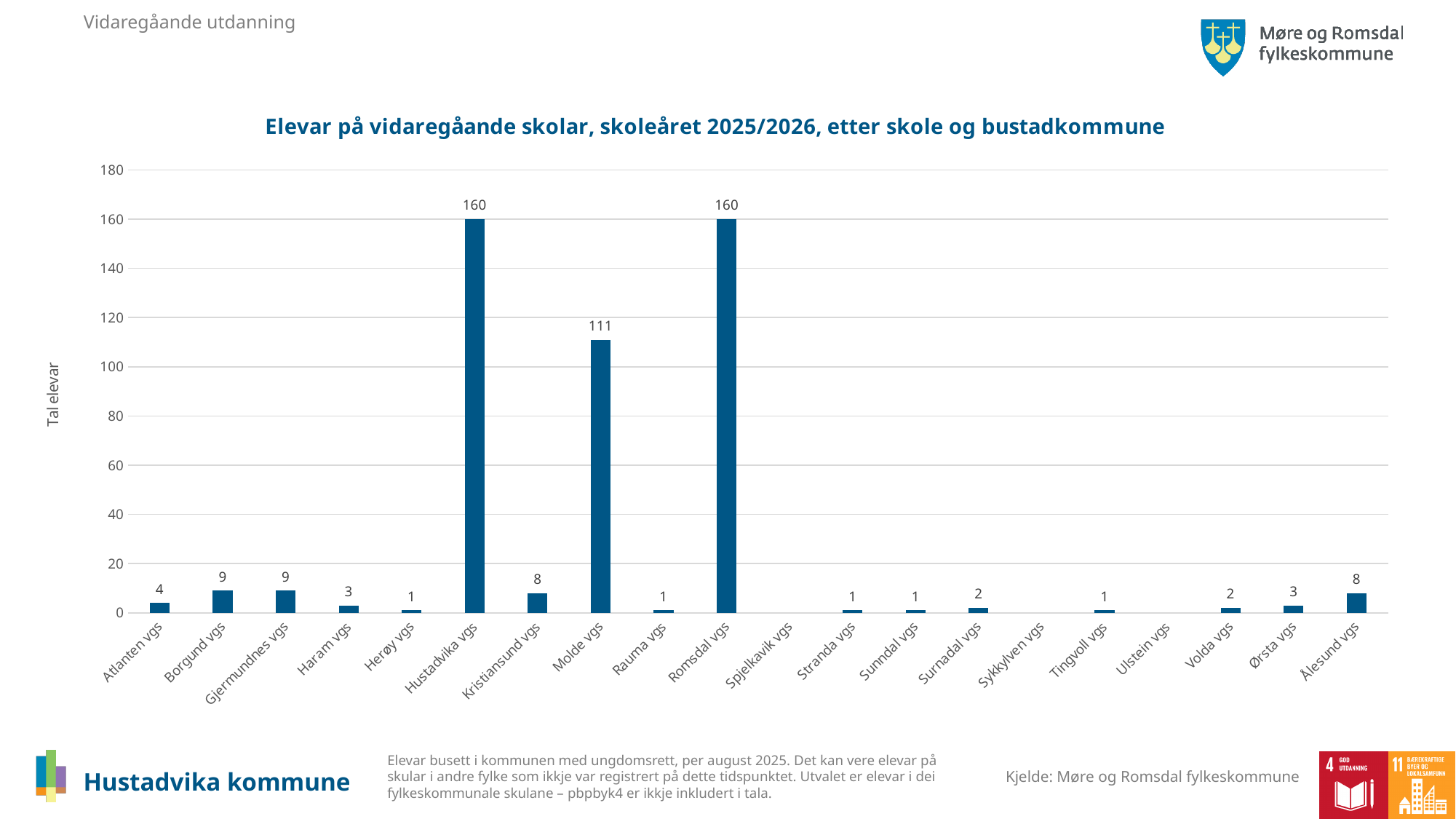
What kind of chart is shown on the slide? bar chart What is the value for Ålesund vgs? 8 What is the value for Molde vgs? 111 What is the value for Kristiansund vgs? 8 What is the difference between the values for Borgund vgs and Atlanten vgs? 5 What is the value for Hustadvika vgs? 160 What is the label on the vertical axis? Tal elevar What is the value for Borgund vgs? 9 How many schools are shown on the x axis? 20 Is the value for Molde vgs greater or less than 100? greater Which is larger, the value for Molde vgs or the value for Romsdal vgs? Romsdal vgs What is the difference between the values for Hustadvika vgs and Molde vgs? 49